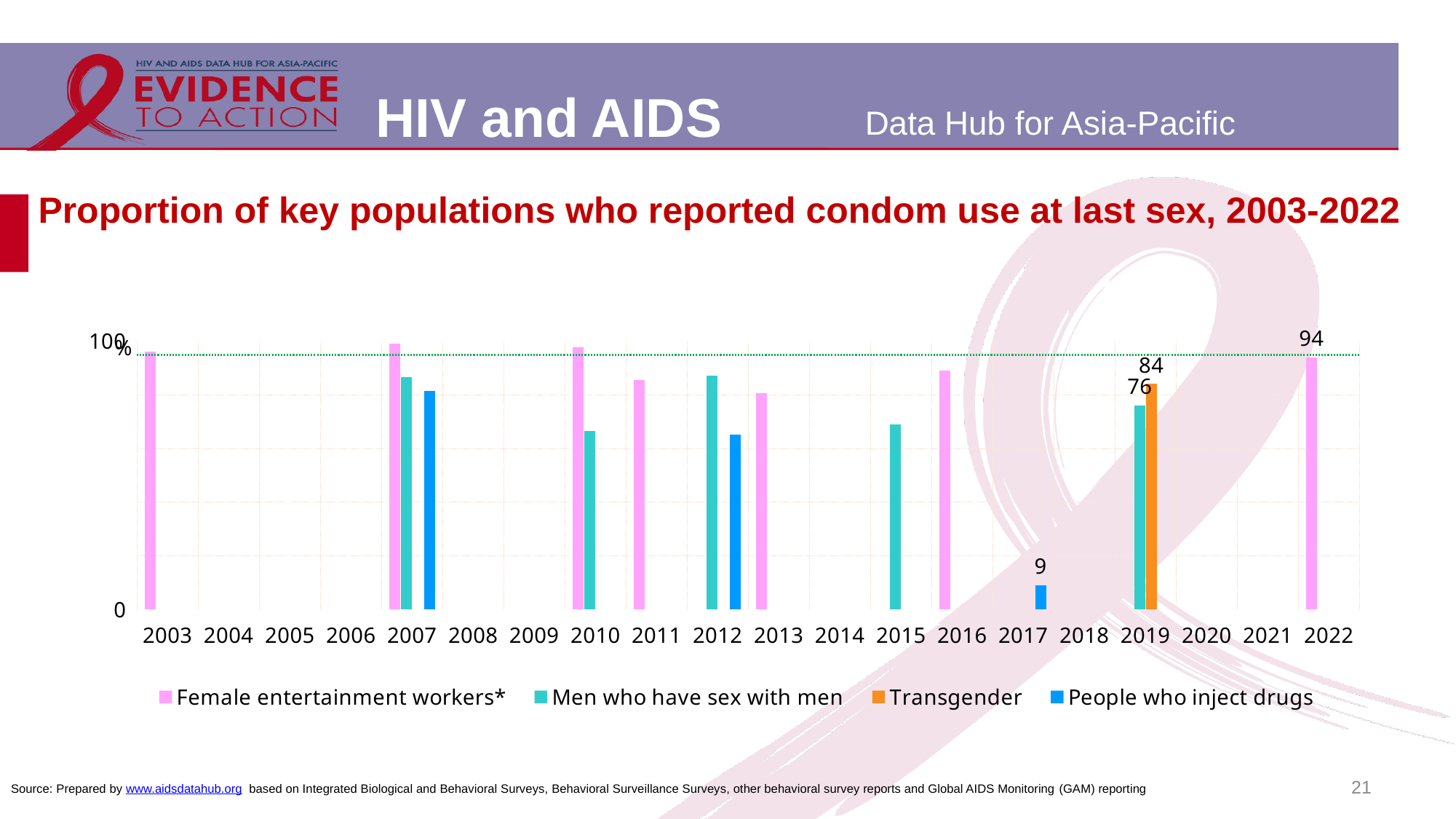
How many series does the legend list? 4 What colour represents the Transgender series in the legend? orange How many years are shown on the x axis? 20 Which bar on the chart has the lowest value? People who inject drugs in 2017 What is the value for People who inject drugs in 2017? 9 In 2019, which is larger: the Transgender value or the Men who have sex with men value? Transgender What kind of chart is shown on the slide? bar chart What is the value for Female entertainment workers in 2022? 94 What is the value for Transgender in 2019? 84 What is the difference between the Female entertainment workers value in 2022 and the People who inject drugs value in 2017? 85 What is the value for Men who have sex with men in 2019? 76 What is the difference between the Transgender value and the Men who have sex with men value in 2019? 8